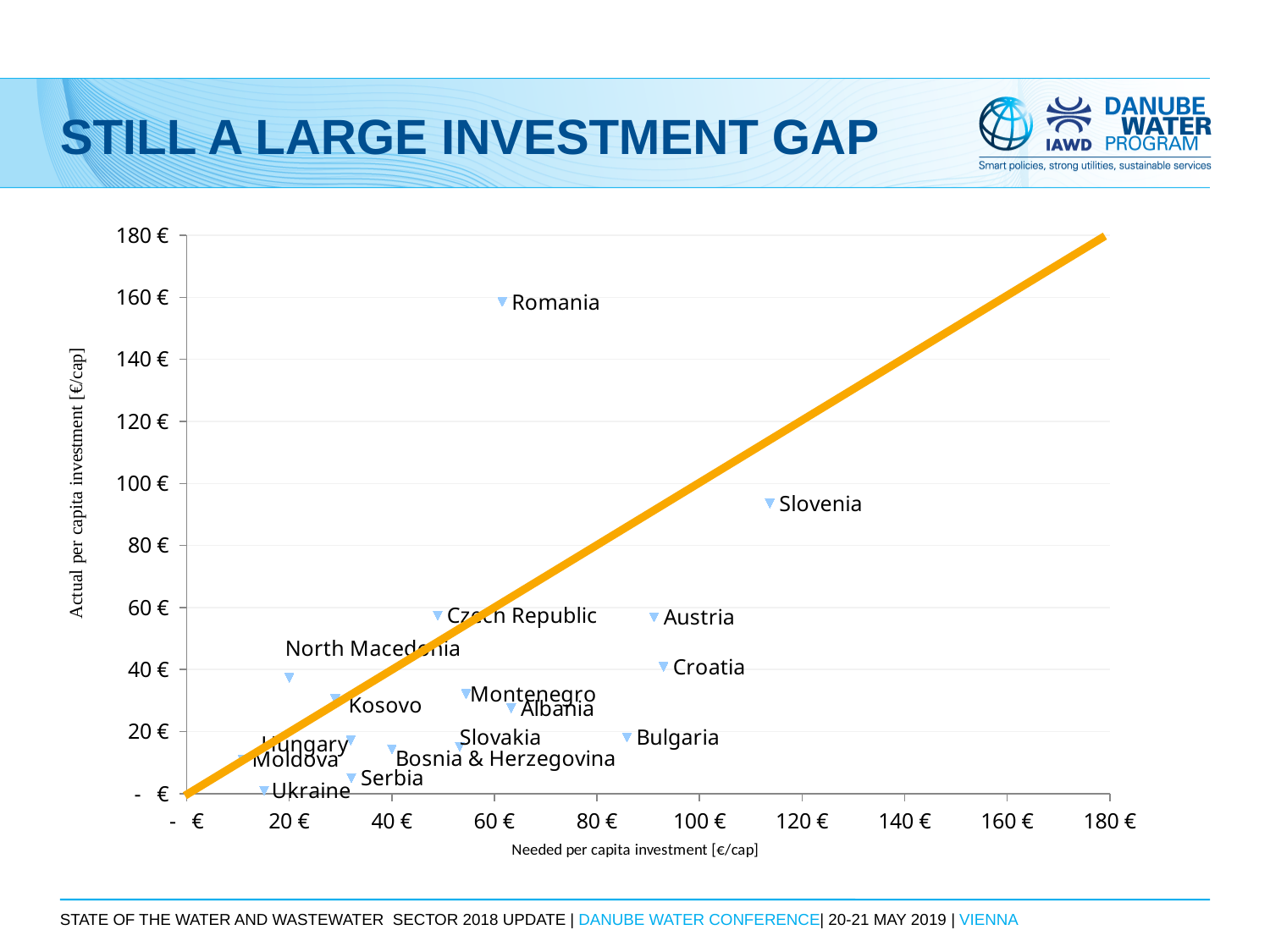
Is the actual per capita investment for Croatia greater or less than 60 €? less What is the label of the y axis? Actual per capita investment [€/cap] Is the needed per capita investment for Austria greater or less than 80 €? greater Is the actual per capita investment for Romania greater or less than 140 €? greater Which country has the highest actual per capita investment? Romania Which country has the lowest actual per capita investment? Ukraine Which has a higher actual per capita investment, Austria or Croatia? Austria What is the label of the x axis? Needed per capita investment [€/cap] Which country has the highest needed per capita investment? Slovenia How many countries are plotted on the chart? 16 What kind of chart is shown on the slide? Scatter chart